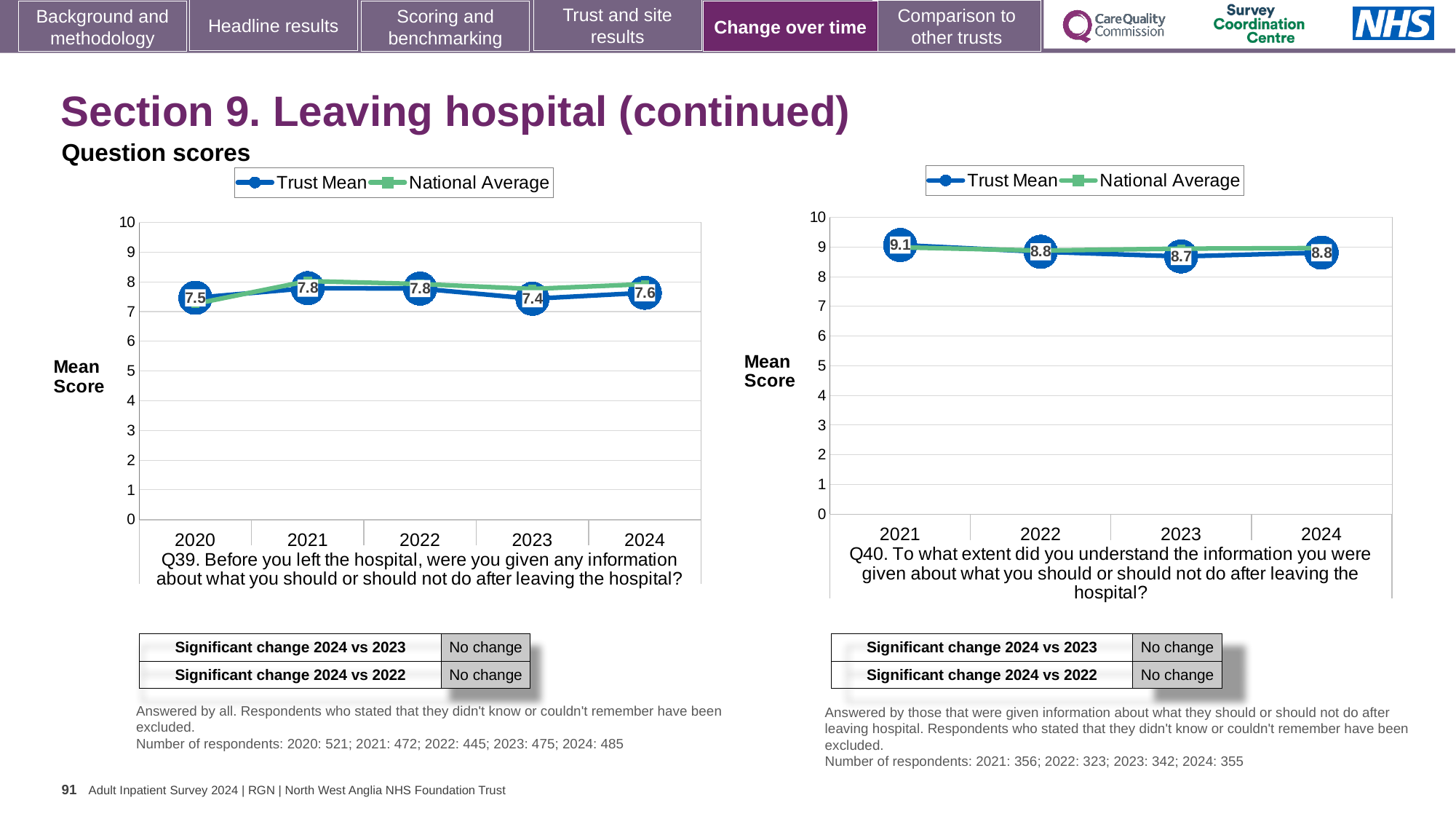
In the Q40 chart on the right, what is the Trust Mean score for 2023? 8.7 In the Q40 chart on the right, which year has the highest Trust Mean score? 2021 In the Q39 chart on the left, is the Trust Mean score for 2024 greater or less than 8? less In the Q39 chart on the left, which year has the lowest Trust Mean score? 2023 In the Q39 chart on the left, what is the Trust Mean score for 2020? 7.5 In the Q40 chart on the right, is the Trust Mean score for 2021 larger or smaller than the score for 2023? larger In the Q39 chart on the left, how many years are plotted on the x axis? 5 In the Q39 chart on the left, what is the difference between the Trust Mean scores for 2021 and 2023? 0.4 In the Q39 chart on the left, what is the Trust Mean score for 2023? 7.4 What type of chart is the Q40 chart on the right? Line chart In the Q40 chart on the right, how many series does the legend list? 2 In the Q40 chart on the right, what is the Trust Mean score for 2021? 9.1